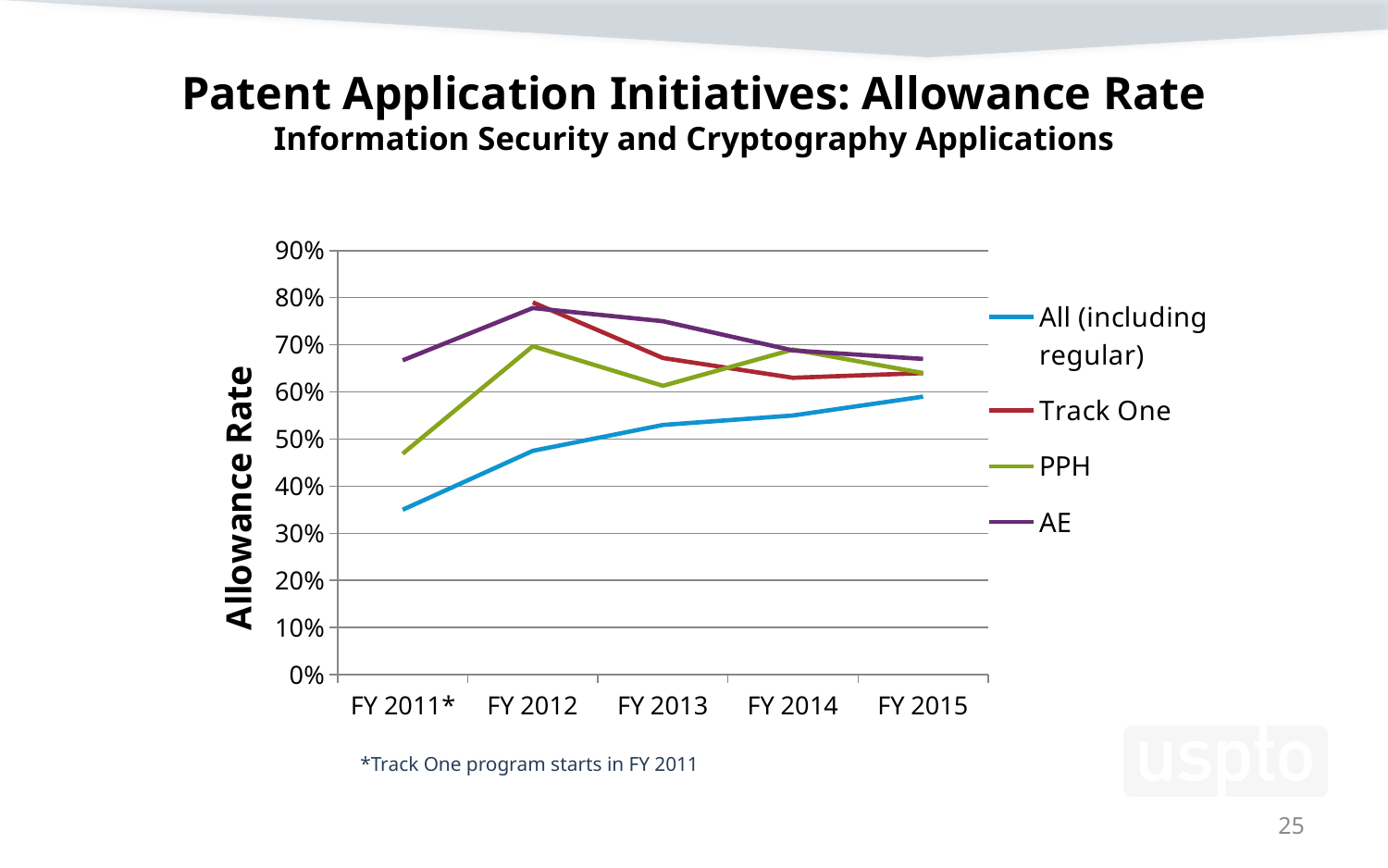
What kind of chart is shown on the slide? line chart Which series has the lowest allowance rate in FY 2015? All (including regular) Does the allowance rate for All (including regular) rise or fall from FY 2011 to FY 2015? rise Which series has the highest allowance rate in FY 2011? AE What is the title of the vertical axis? Allowance Rate Is the value for AE in FY 2012 greater or less than 70%? greater In FY 2011, which has the higher allowance rate, AE or All (including regular)? AE Is the value for PPH in FY 2011 greater or less than 50%? less Is the value for All (including regular) in FY 2011 greater or less than 40%? less How many series does the legend list? 4 In FY 2012, which has the higher allowance rate, PPH or All (including regular)? PPH How many fiscal years are shown on the x axis? 5